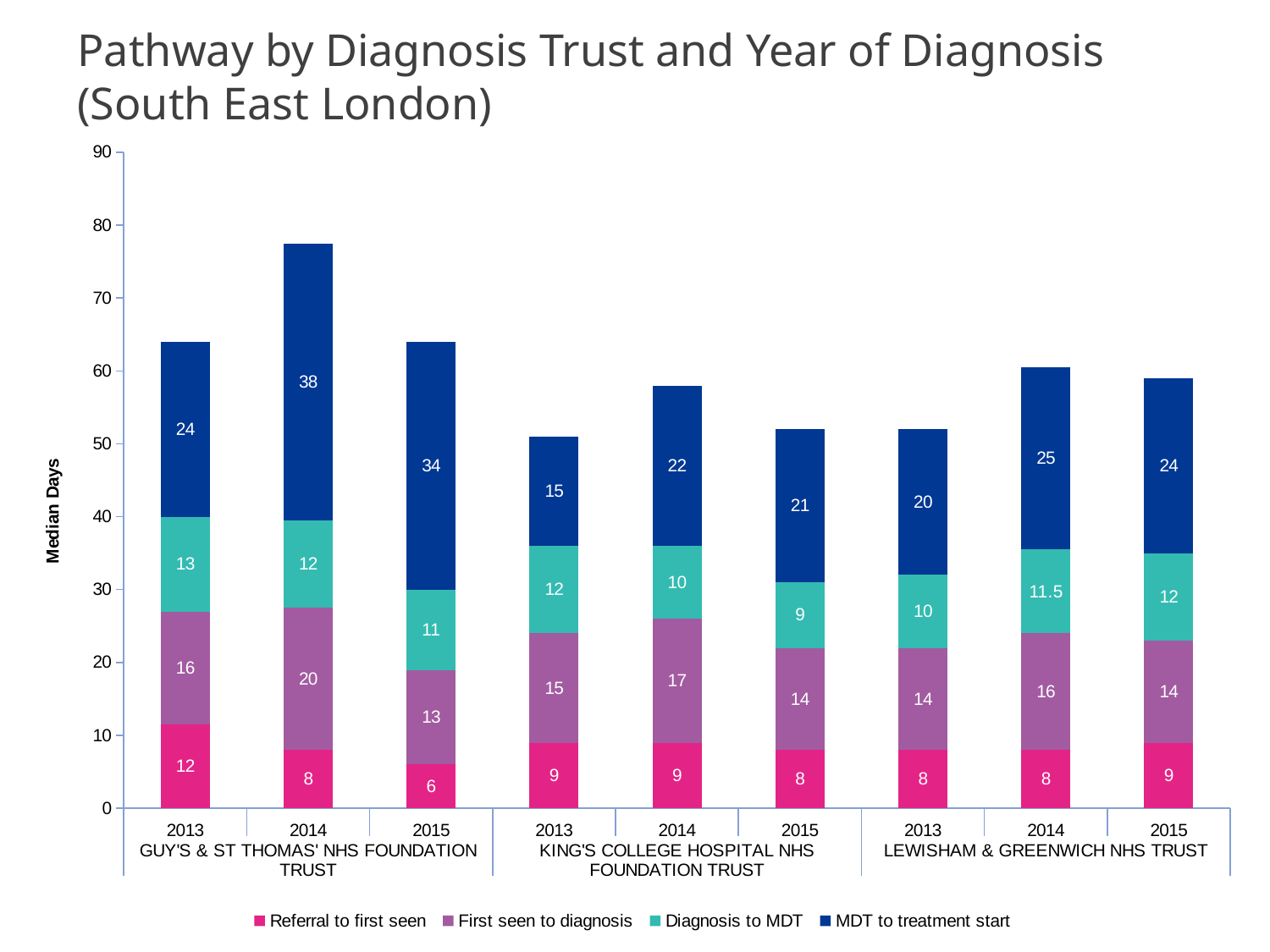
What is the value for Diagnosis to MDT for Lewisham & Greenwich NHS Trust in 2014? 11.5 What kind of chart is shown on the slide? Stacked bar chart Which is larger in 2014: First seen to diagnosis for King's College Hospital NHS Foundation Trust or for Lewisham & Greenwich NHS Trust? King's College Hospital NHS Foundation Trust Which bar has the lowest value for Referral to first seen? Guy's & St Thomas' NHS Foundation Trust, 2015 Which bar has the highest value for MDT to treatment start? Guy's & St Thomas' NHS Foundation Trust, 2014 What is the value for MDT to treatment start for Guy's & St Thomas' NHS Foundation Trust in 2014? 38 Is the total height of the 2014 bar for Guy's & St Thomas' NHS Foundation Trust greater or less than 70? greater What is the difference in MDT to treatment start between 2014 and 2013 for Guy's & St Thomas' NHS Foundation Trust? 14 How many bars are plotted in the chart? 9 Does the Referral to first seen value for Guy's & St Thomas' NHS Foundation Trust rise or fall from 2013 to 2015? fall How many series does the legend list? 4 What is the total of the stacked bar for King's College Hospital NHS Foundation Trust in 2015? 52